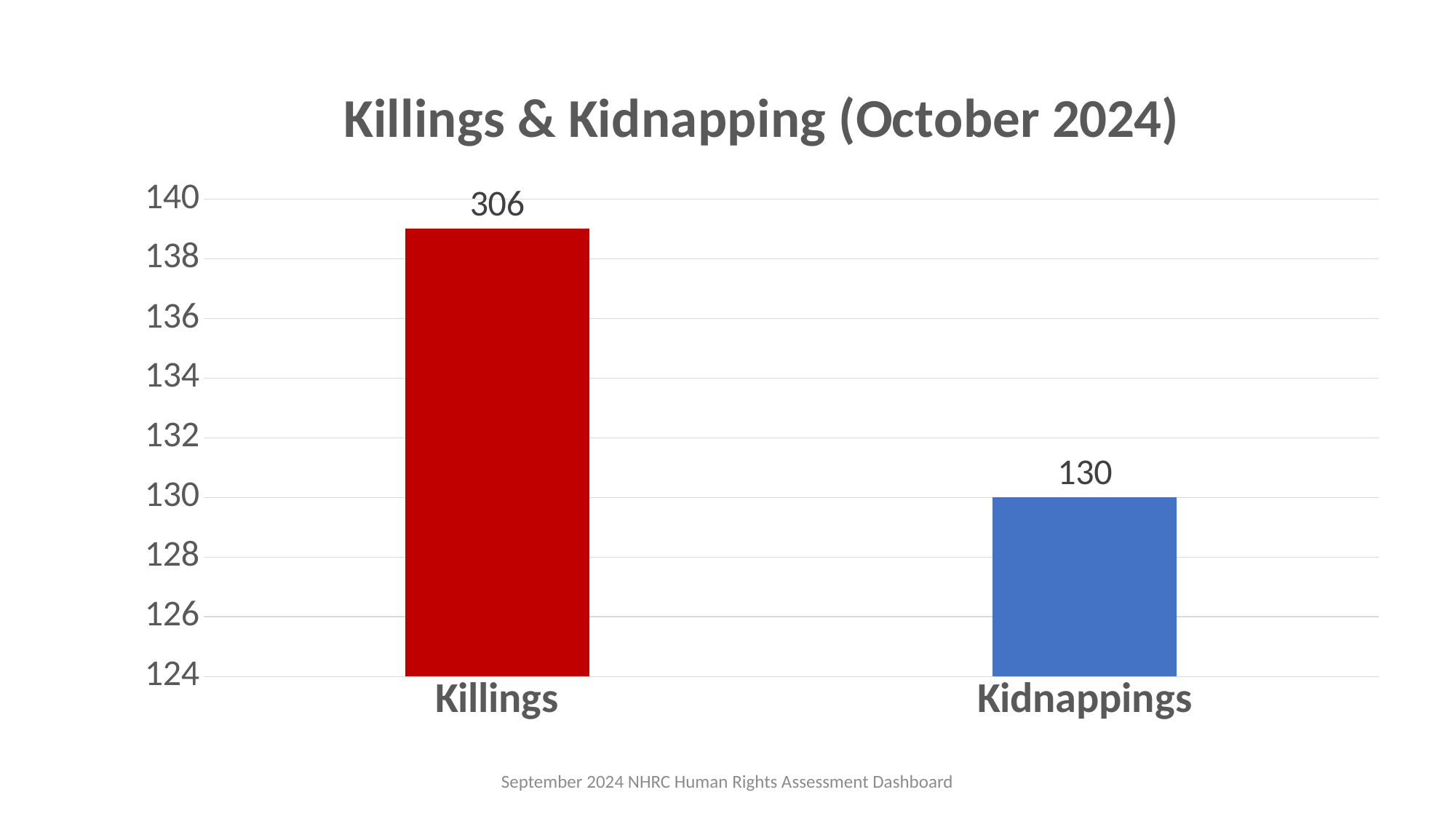
What is the title of the chart? Killings & Kidnapping (October 2024) Which category has the highest value? Killings Which is larger, the value for Killings or the value for Kidnappings? Killings What kind of chart is shown on the slide? Bar chart What is the value shown for Killings? 306 What is the value shown for Kidnappings? 130 Which category has the lowest value? Kidnappings What colour is the bar for Killings? Red How many categories are shown on the chart? 2